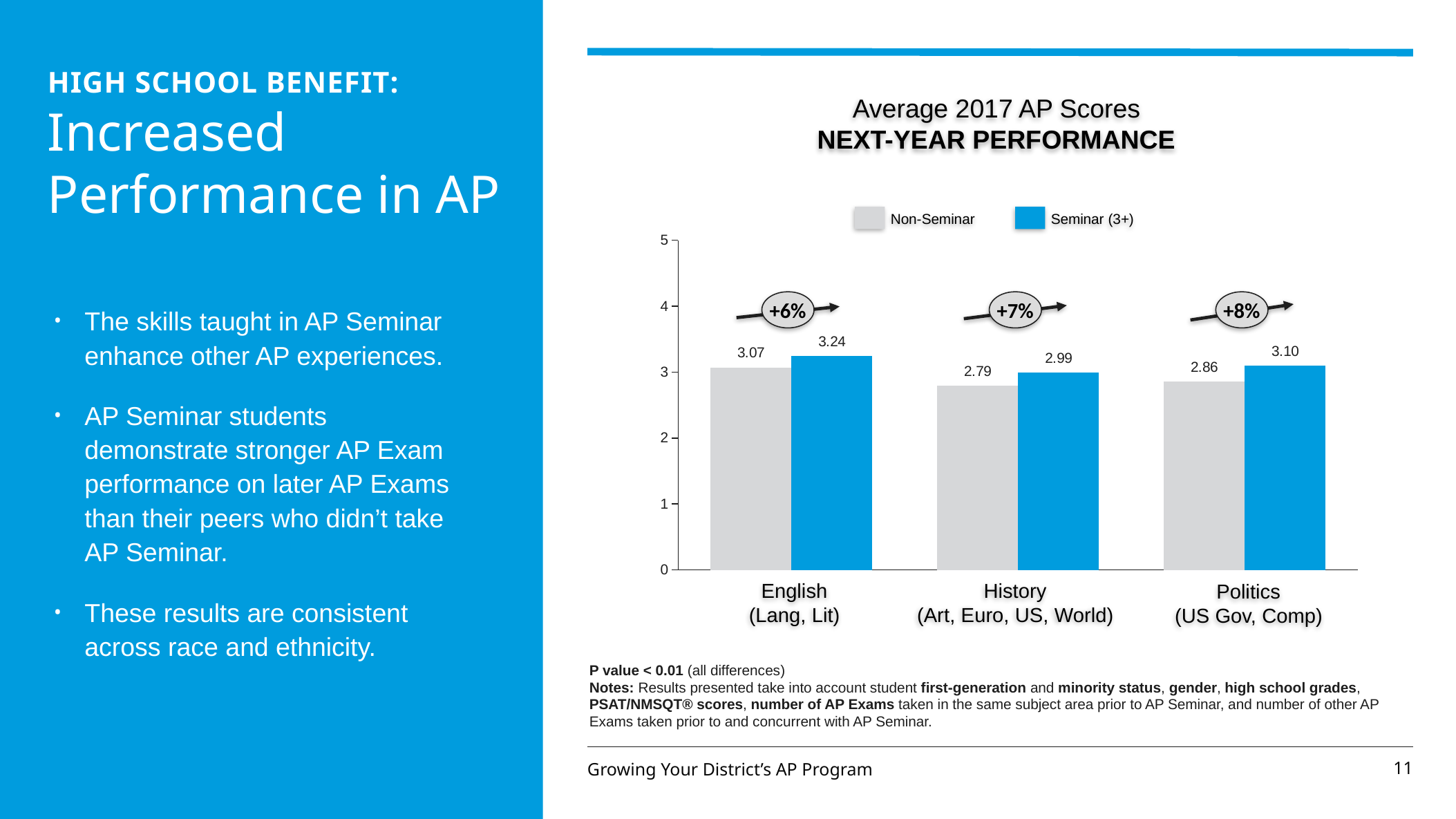
What is the Non-Seminar average AP score for English (Lang, Lit)? 3.07 Which subject group has the lowest Non-Seminar average score? History (Art, Euro, US, World) Is the Non-Seminar value for History (Art, Euro, US, World) greater or less than 3? less How many series does the legend list? 2 Which subject group has the highest Seminar (3+) average score? English (Lang, Lit) What percentage increase is labelled above the History bars? +7% What is the Seminar (3+) average AP score for History (Art, Euro, US, World)? 2.99 How many subject groups are shown on the x axis? 3 What is the Seminar (3+) average AP score for Politics (US Gov, Comp)? 3.10 What is the difference between the Seminar (3+) and Non-Seminar scores for Politics (US Gov, Comp)? 0.24 What kind of chart is shown on the slide? Bar chart Which is larger for History: the Non-Seminar score or the Seminar (3+) score? Seminar (3+)